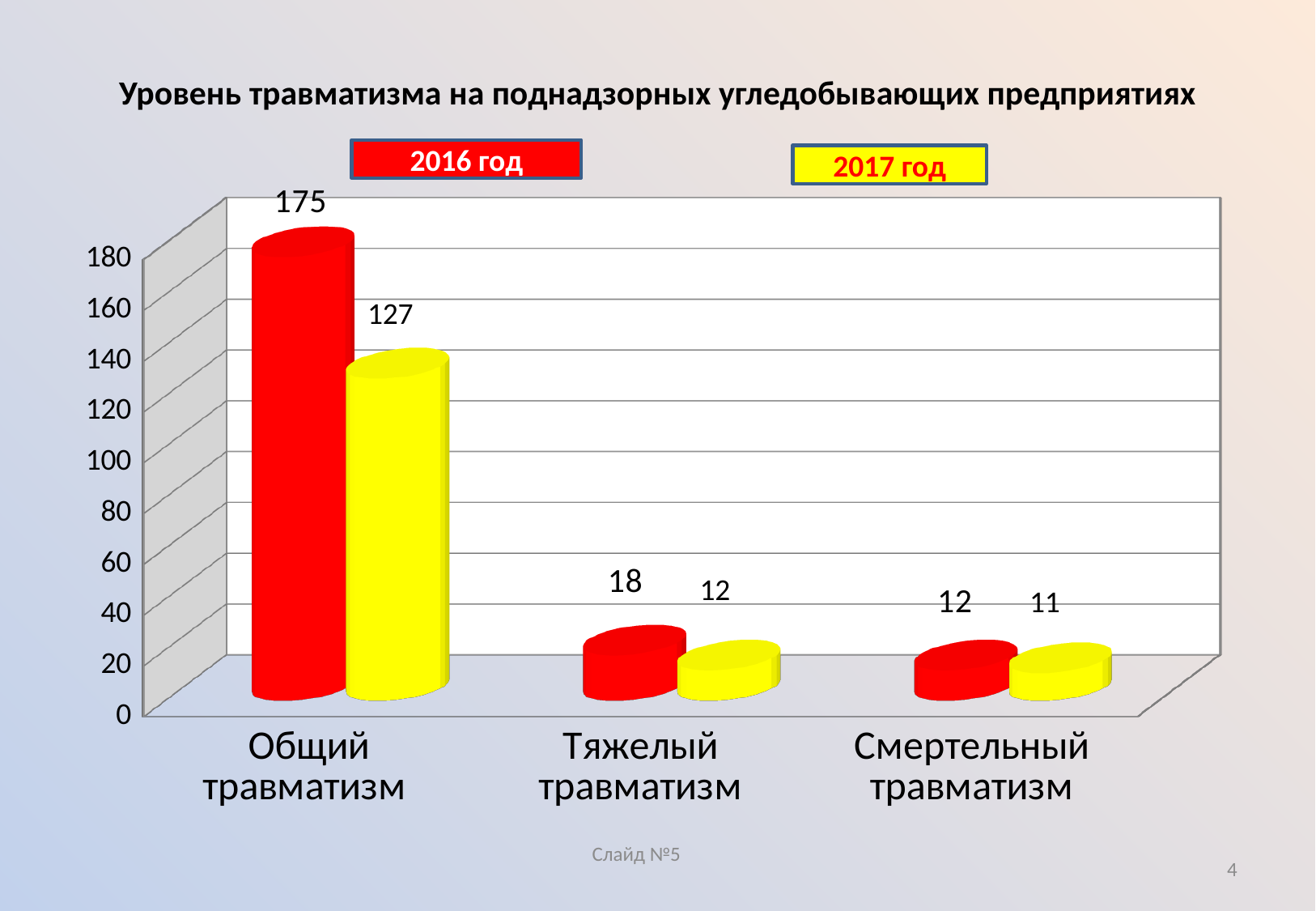
How many categories are shown on the x axis? 3 How many series does the legend list? 2 What is the difference between the 2016 год and 2017 год values for Тяжелый травматизм? 6 What kind of chart is shown on the slide? Bar chart What is the value for Тяжелый травматизм in 2016 год? 18 What is the value for Смертельный травматизм in 2017 год? 11 What is the difference between the 2016 год and 2017 год values for Общий травматизм? 48 Which category has the lowest value for 2017 год? Смертельный травматизм Which category has the highest value for 2016 год? Общий травматизм What is the value for Общий травматизм in 2017 год? 127 What is the value for Общий травматизм in 2016 год? 175 Which is larger for Общий травматизм: the 2016 год value or the 2017 год value? 2016 год